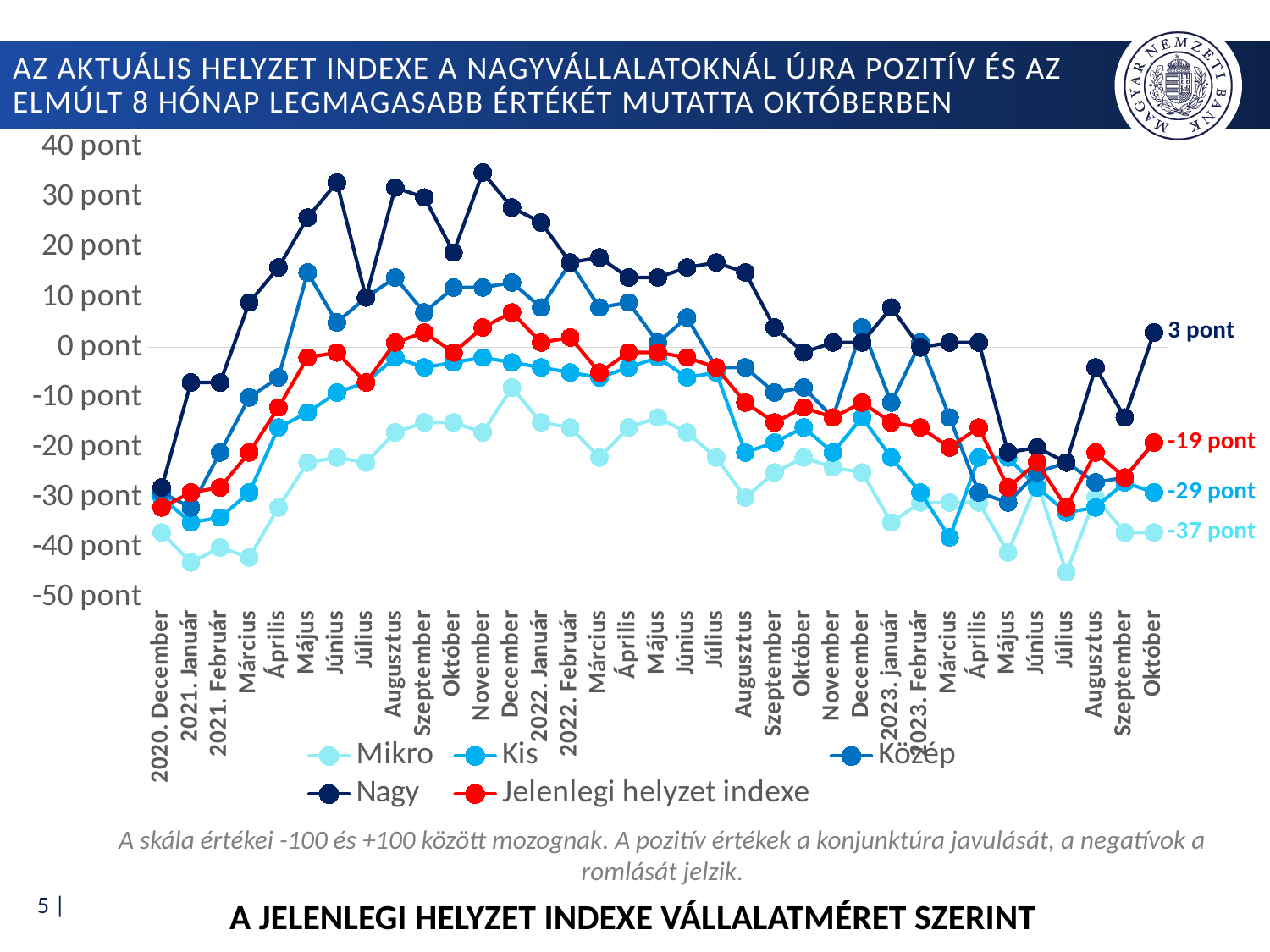
Which series has the highest value in 2023 Október? Nagy What is the title of the chart? A jelenlegi helyzet indexe vállalatméret szerint What is the value of the Jelenlegi helyzet indexe series in 2023 Október? -19 pont What is the value of the Mikro series in 2023 Október? -37 pont How many series does the legend list? 5 Is the value for Mikro in 2021 Január greater or less than -40 pont? less What kind of chart is shown on the slide? line chart Is the value for Nagy in 2021 Június greater or less than 30 pont? greater What is the difference between the Nagy value and the Jelenlegi helyzet indexe value in 2023 Október? 22 pont Which series has the lowest value in 2023 Október? Mikro What is the difference between the Nagy and Mikro values in 2023 Október? 40 pont What is the value of the Nagy series in 2023 Október? 3 pont